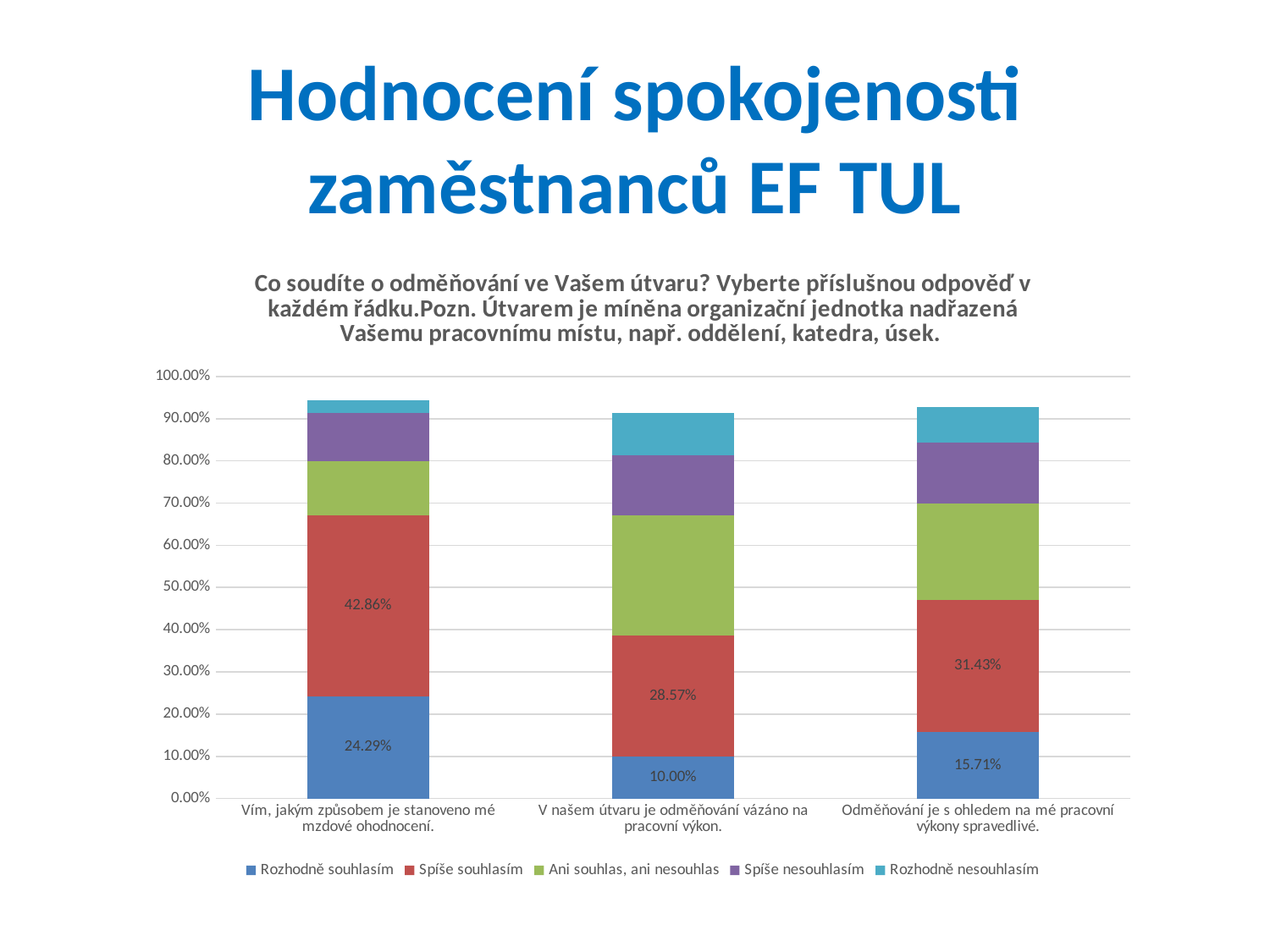
Is the "Ani souhlas, ani nesouhlas" value for "V našem útvaru je odměňování vázáno na pracovní výkon." greater or less than 20%? greater What is the value of "Rozhodně souhlasím" for "Odměňování je s ohledem na mé pracovní výkony spravedlivé."? 15.71% Which statement has the lowest "Rozhodně souhlasím" value? V našem útvaru je odměňování vázáno na pracovní výkon. Which statement has the highest "Spíše souhlasím" value? Vím, jakým způsobem je stanoveno mé mzdové ohodnocení. How many statements (categories) are shown on the x axis of the chart? 3 How many series does the chart legend list? 5 What is the value of "Rozhodně souhlasím" for "Vím, jakým způsobem je stanoveno mé mzdové ohodnocení."? 24.29% What is the value of "Spíše souhlasím" for "Odměňování je s ohledem na mé pracovní výkony spravedlivé."? 31.43% What is the value of "Spíše souhlasím" for "V našem útvaru je odměňování vázáno na pracovní výkon."? 28.57% What is the difference between the "Spíše souhlasím" values for "Vím, jakým způsobem je stanoveno mé mzdové ohodnocení." and "V našem útvaru je odměňování vázáno na pracovní výkon."? 14.29% Which is larger: the "Rozhodně souhlasím" value for "Vím, jakým způsobem je stanoveno mé mzdové ohodnocení." or for "Odměňování je s ohledem na mé pracovní výkony spravedlivé."? Vím, jakým způsobem je stanoveno mé mzdové ohodnocení. What kind of chart is shown on the slide? Stacked bar chart